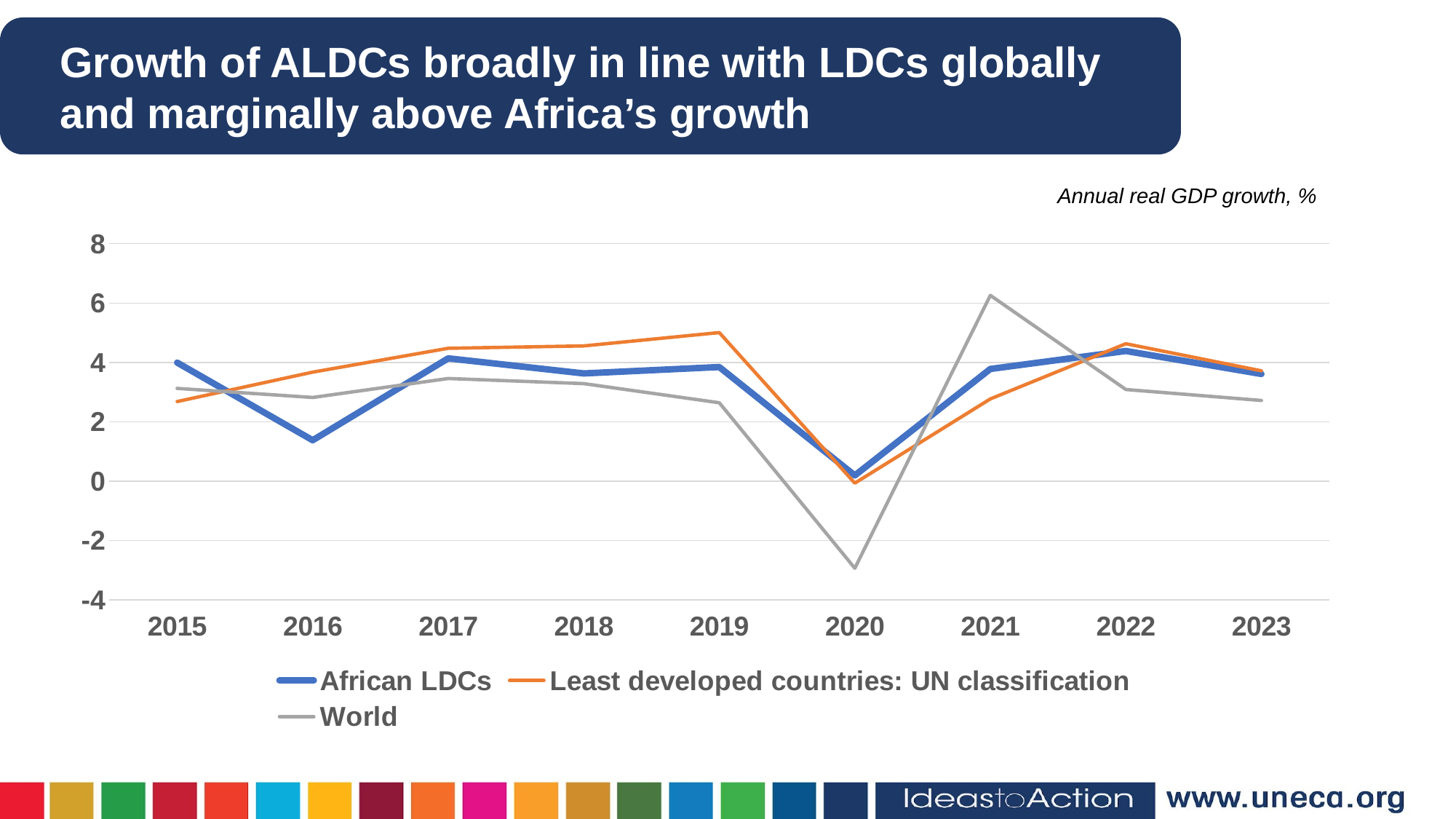
In 2021, which series has the higher value: World or African LDCs? World In which year is the World series at its highest? 2021 How many years are shown on the x axis? 9 What unit is given for the values in the chart, as stated above the plot area? Annual real GDP growth, % What kind of chart is shown on the slide? line chart Is the value for World in 2020 greater or less than -2? less Does the World series rise or fall from 2021 to 2023? fall Is the value for African LDCs in 2016 greater or less than 2? less In which year is the World series at its lowest? 2020 How many series does the legend list? 3 Is the value for Least developed countries: UN classification in 2019 greater or less than 4? greater In which year is the African LDCs series at its lowest? 2020